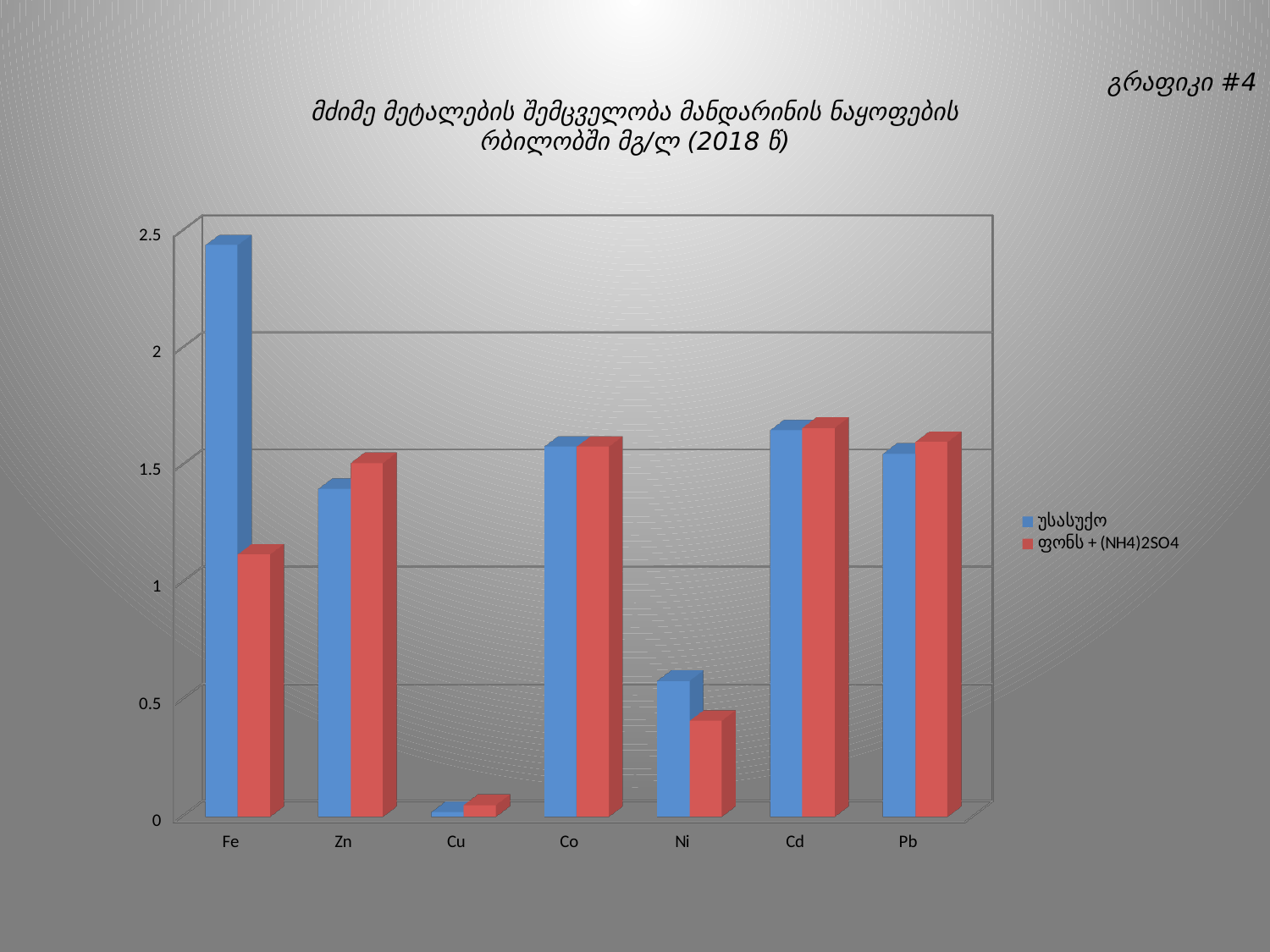
Is the უსასუქო value for Fe greater or less than 2? greater What kind of chart is shown on the slide? bar chart Which category has the highest value for the უსასუქო series? Fe Is the ფონს + (NH4)2SO4 value for Ni greater or less than 0.5? less Which series is shown in red in the legend? ფონს + (NH4)2SO4 How many categories are shown on the x axis? 7 For Fe, which series has the larger value, უსასუქო or ფონს + (NH4)2SO4? უსასუქო Which category has the lowest value for the ფონს + (NH4)2SO4 series? Cu For Ni, which series has the larger value, უსასუქო or ფონს + (NH4)2SO4? უსასუქო How many series does the legend list? 2 Is the უსასუქო value for Zn greater or less than 1.5? less Which category has the lowest value for the უსასუქო series? Cu